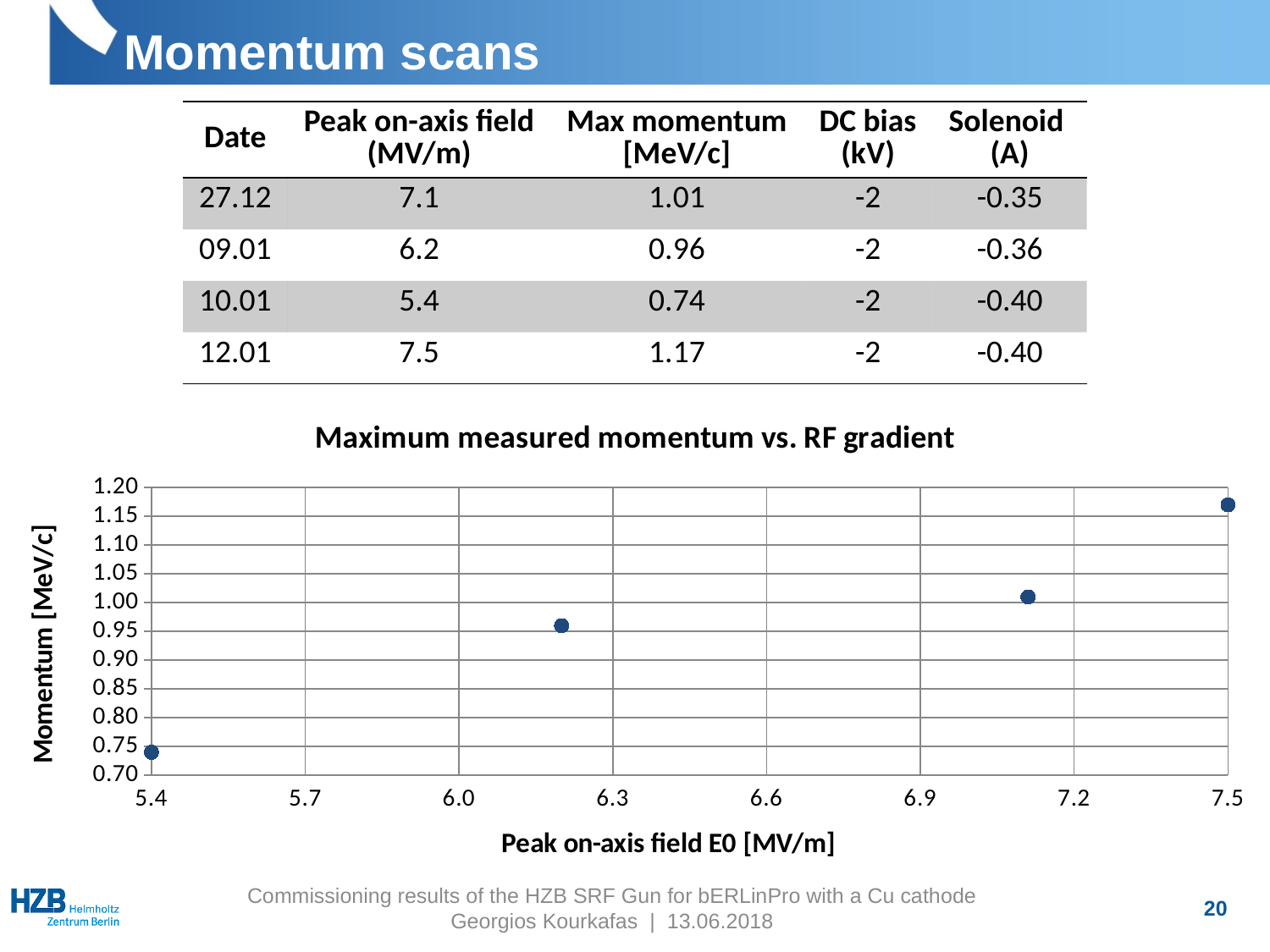
Is the momentum at a peak on-axis field of 6.2 MV/m greater or less than 1.00 MeV/c? less Is the momentum at a peak on-axis field of 7.5 MV/m greater or less than 1.10 MeV/c? greater Which has the larger momentum: the point at 7.1 MV/m or the point at 6.2 MV/m? 7.1 MV/m At which peak on-axis field value is the plotted momentum highest? 7.5 How many data points are plotted in the chart? 4 What is the maximum momentum in MeV/c measured at a peak on-axis field of 7.5 MV/m? 1.17 At which peak on-axis field value is the plotted momentum lowest? 5.4 Does the momentum rise or fall as the peak on-axis field increases along the x axis? rise Is the momentum at a peak on-axis field of 5.4 MV/m greater or less than 0.80 MeV/c? less What is the title of the chart? Maximum measured momentum vs. RF gradient What is the label of the y axis of the chart? Momentum [MeV/c] What type of chart is shown on the slide? scatter chart